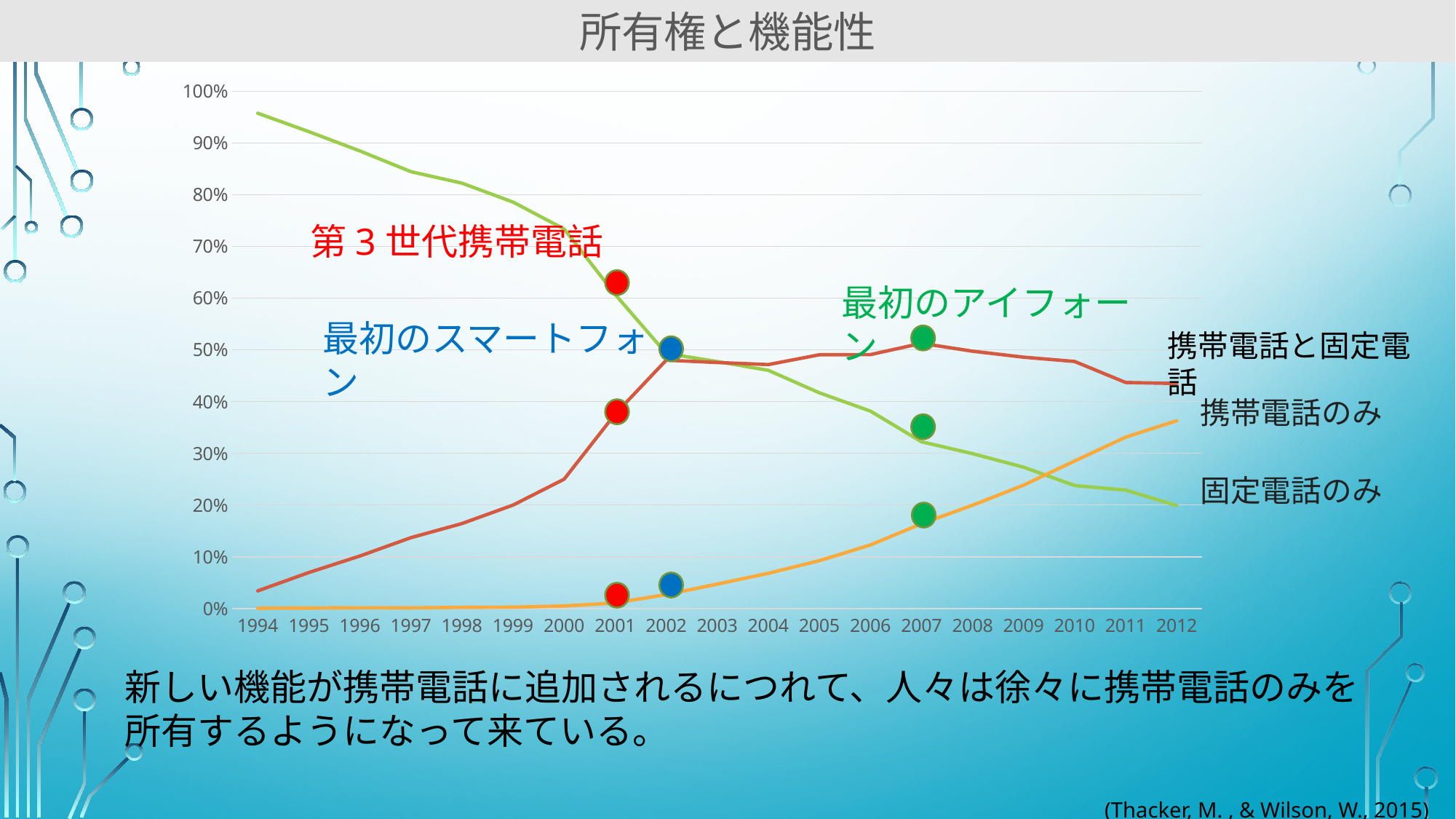
Is the value for 携帯電話と固定電話 in 1994 greater or less than 10%? less What is the title of the slide containing the chart? 所有権と機能性 Does the value for 携帯電話のみ rise or fall from 1994 to 2012? rise How many data series (lines) are plotted in the chart? 3 In 2012, which is larger: 携帯電話のみ or 固定電話のみ? 携帯電話のみ Is the value for 携帯電話のみ in 2012 greater or less than 30%? greater What kind of chart is shown on the slide? line chart How many years are shown along the x axis of the chart? 19 In 2012, which series has the highest value? 携帯電話と固定電話 Does the value for 固定電話のみ rise or fall from 1994 to 2012? fall Is the value for 固定電話のみ in 2012 greater or less than 30%? less